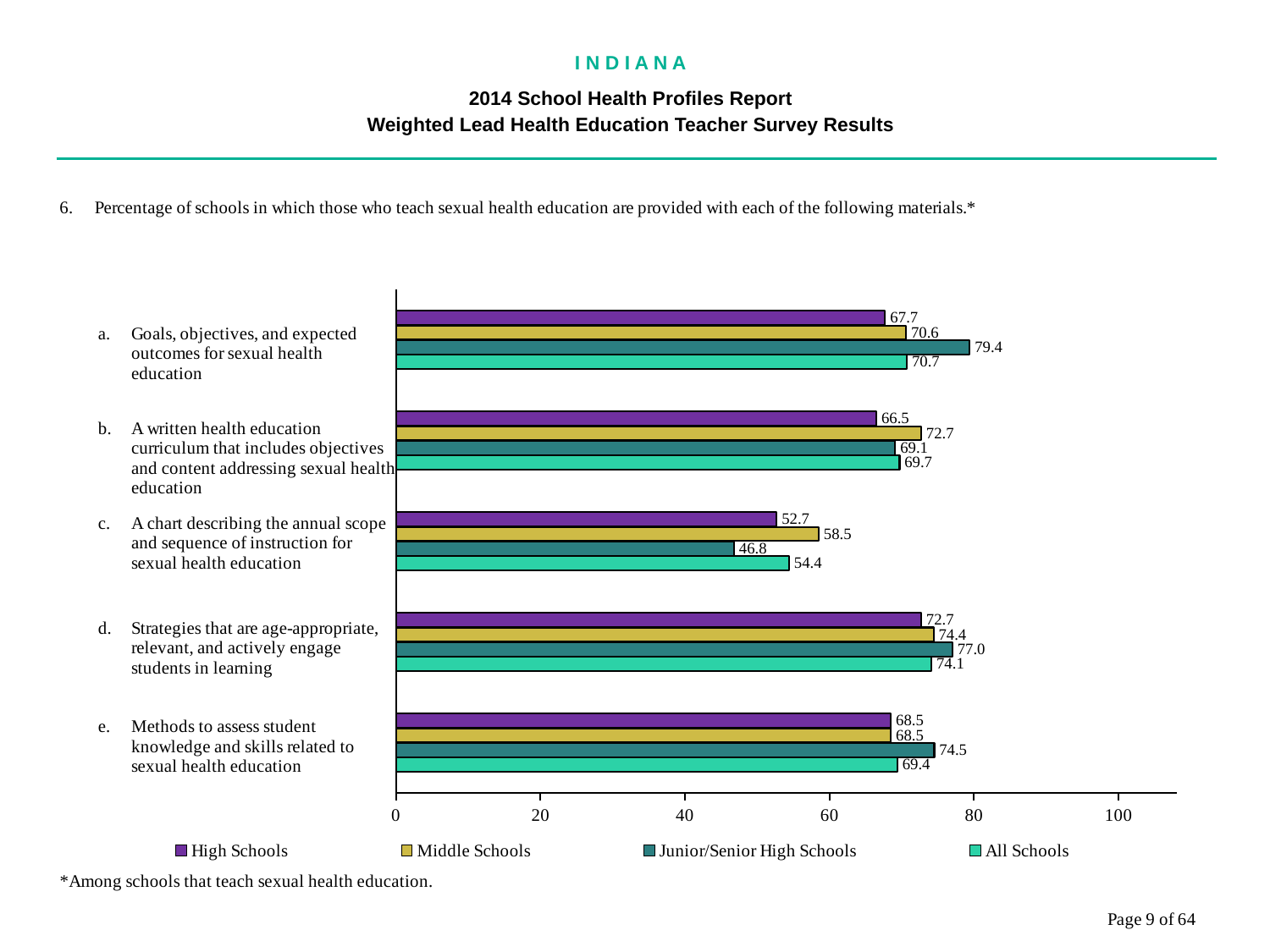
What is the difference between the Junior/Senior High Schools and High Schools values for item a? 11.7 Which item has the lowest Junior/Senior High Schools value? c. A chart describing the annual scope and sequence of instruction for sexual health education Is the Junior/Senior High Schools value for item c greater or less than 60? less Which series is shown in the legend with the purple colour? High Schools What kind of chart is shown on the slide? bar chart How many items (categories) are shown in the chart? 5 Which item has the highest High Schools value? d. Strategies that are age-appropriate, relevant, and actively engage students in learning What is the All Schools value for item e (Methods to assess student knowledge and skills related to sexual health education)? 69.4 What is the value for Junior/Senior High Schools for item a (Goals, objectives, and expected outcomes for sexual health education)? 79.4 How many series does the legend list? 4 For item b, which is larger: the Middle Schools value or the High Schools value? Middle Schools What is the value for Middle Schools for item c (A chart describing the annual scope and sequence of instruction for sexual health education)? 58.5